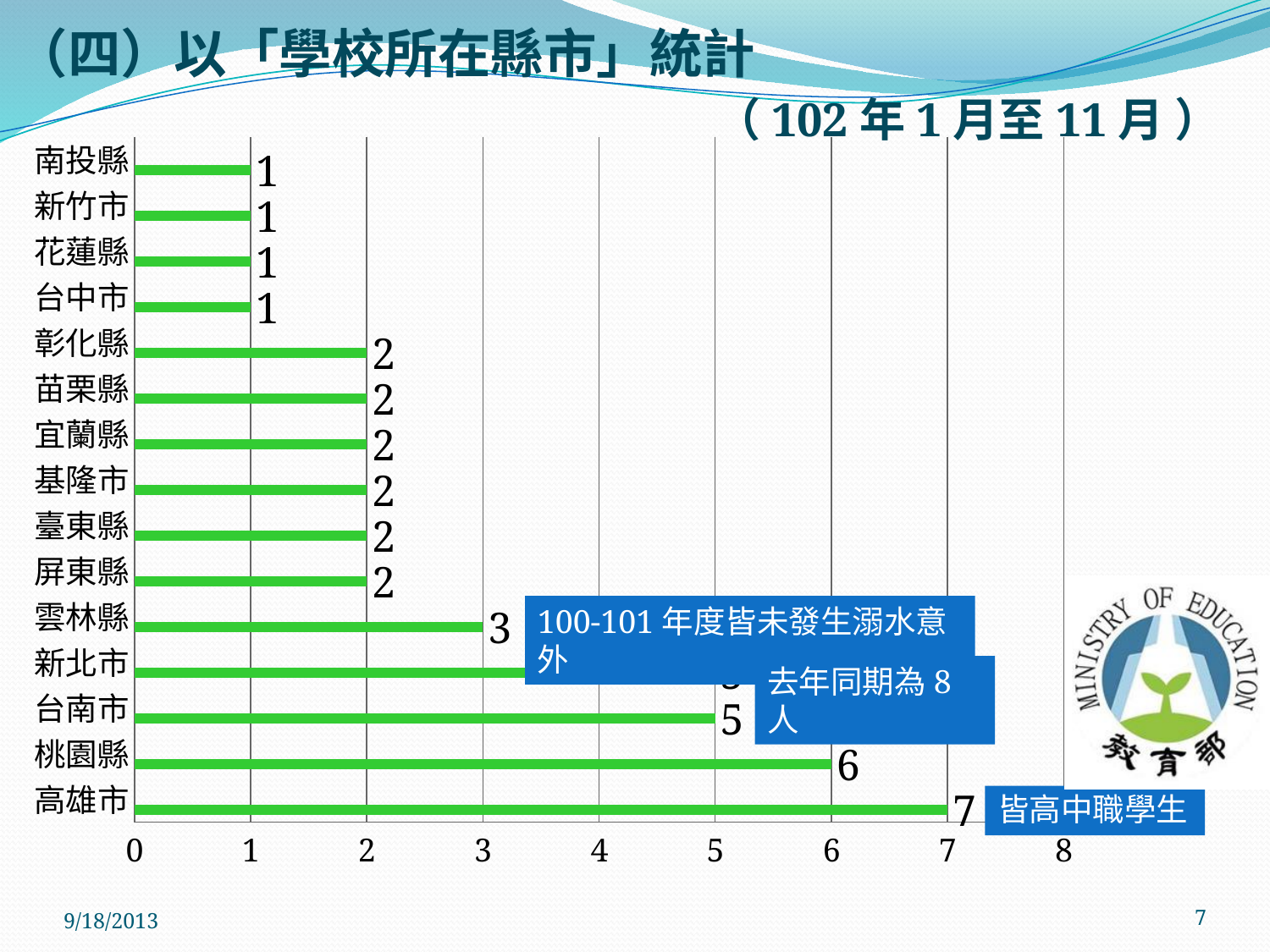
What is the difference between the values for 高雄市 and 桃園縣? 1 How many counties or cities are shown on the chart? 15 What kind of chart is shown on the slide? bar chart Is the value for 新北市 greater or less than 4? greater Which has a larger value, 桃園縣 or 台南市? 桃園縣 What is the value for 桃園縣? 6 What is the difference between the values for 台南市 and 屏東縣? 3 What is the lowest value shown on the chart? 1 What is the value for 高雄市? 7 Which county or city has the highest value? 高雄市 What is the value for 雲林縣? 3 What is the value for 基隆市? 2